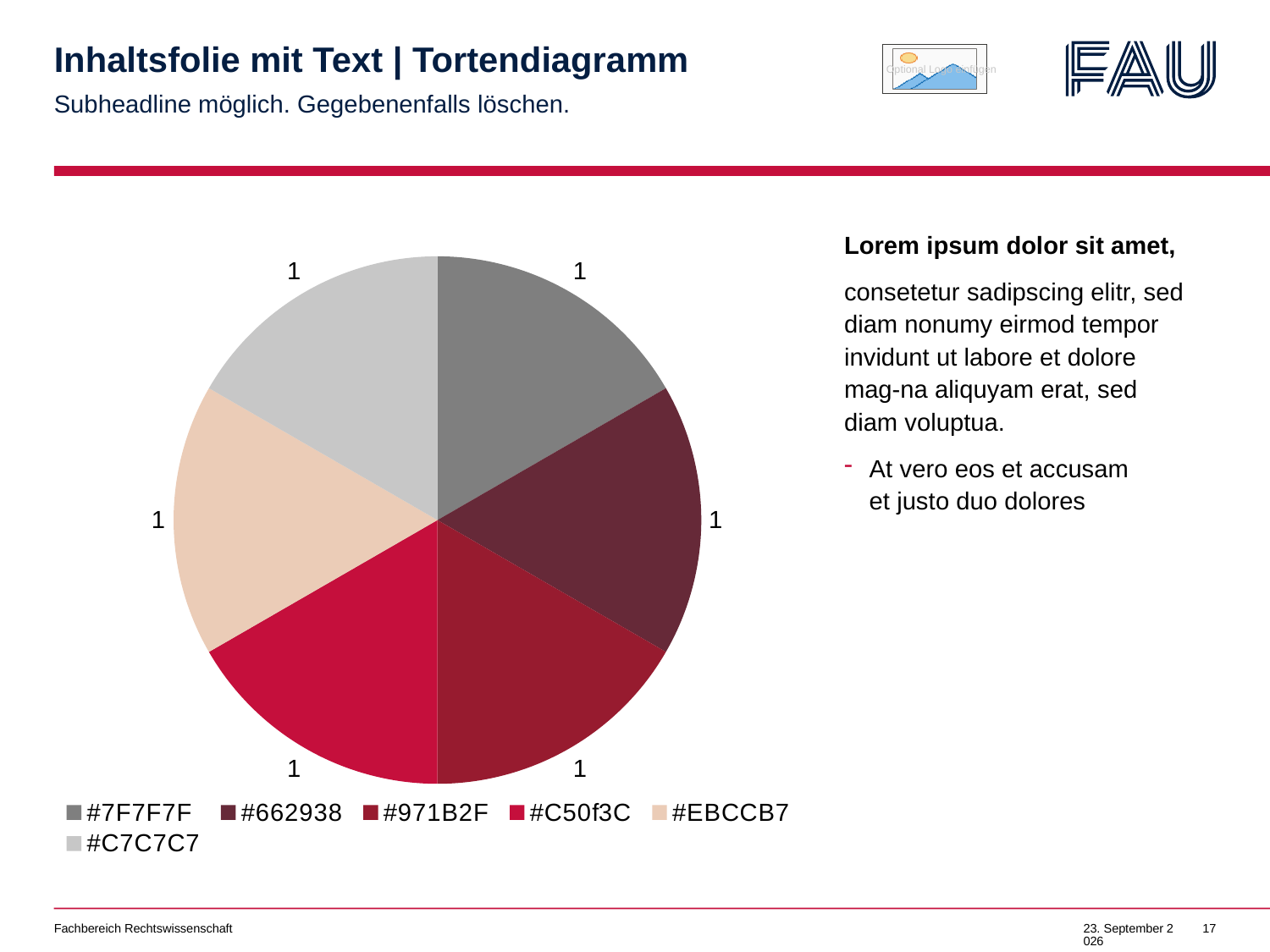
What kind of chart is shown on the slide? pie chart Which legend entry is listed first in the pie chart's legend? #7F7F7F What is the value of the #7F7F7F slice in the pie chart? 1 How many slices does the pie chart have? 6 What is the difference between the values of the #662938 and #971B2F slices? 0 What is the value of the #EBCCB7 slice in the pie chart? 1 How many entries does the legend of the pie chart list? 6 Which legend entry is listed last in the pie chart's legend? #C7C7C7 What is the value of the #C50f3C slice in the pie chart? 1 What is the value of the #C7C7C7 slice in the pie chart? 1 What is the total of all slice values in the pie chart? 6